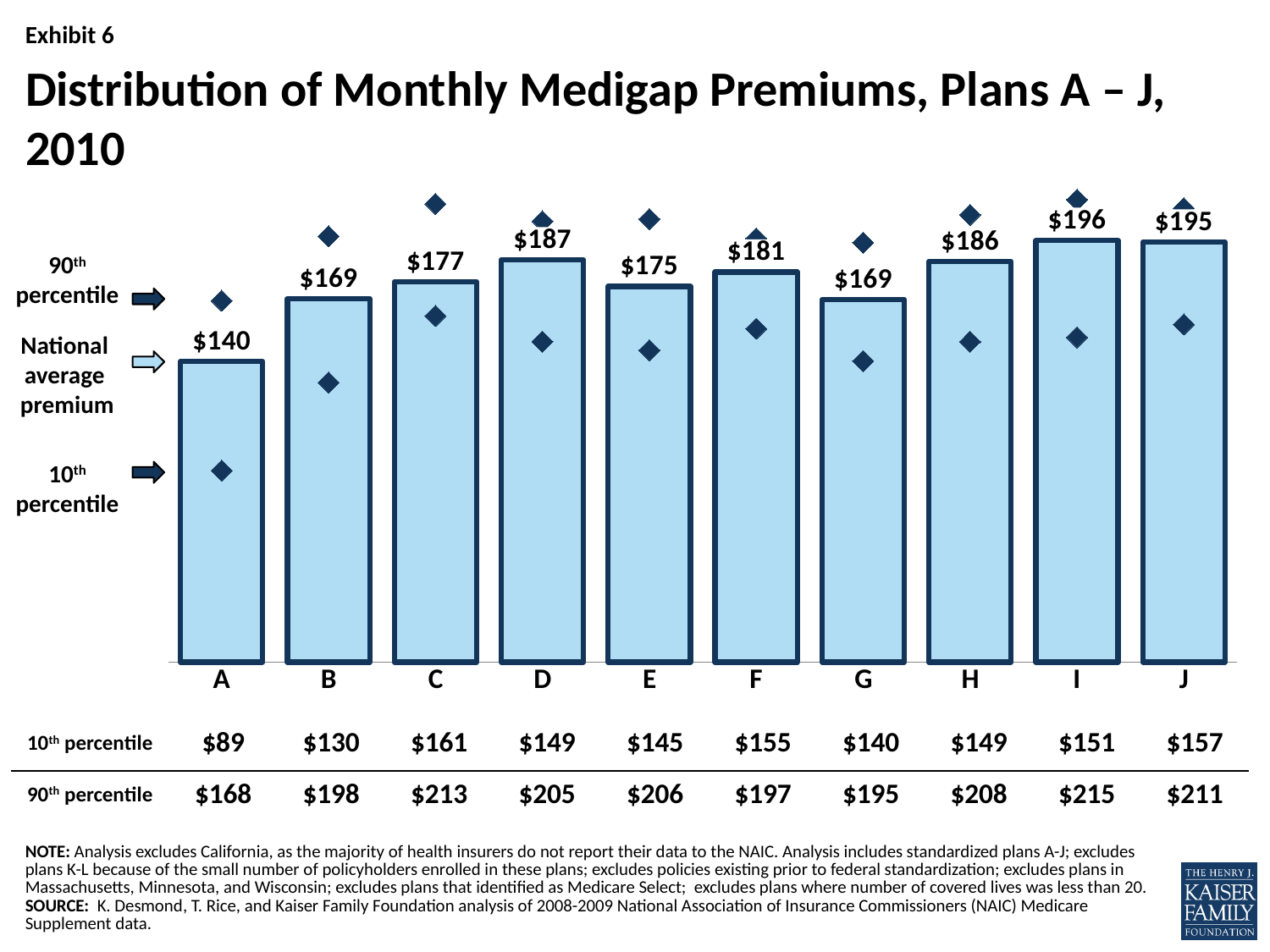
What is the 10th percentile premium for Plan C? $161 What is the difference between the 90th and 10th percentile premiums for Plan A? $79 Which plan has the highest national average premium? I How many plans are shown in the chart? 10 Which has a higher national average premium, Plan C or Plan E? Plan C What is the difference between the national average premiums for Plan D and Plan A? $47 What is the 90th percentile premium for Plan I? $215 What type of chart is used to show the national average premiums? Bar chart What is the national average monthly premium for Plan D? $187 What is the national average monthly premium for Plan A? $140 Which plan has the lowest national average premium? A What is the title of the chart? Distribution of Monthly Medigap Premiums, Plans A – J, 2010